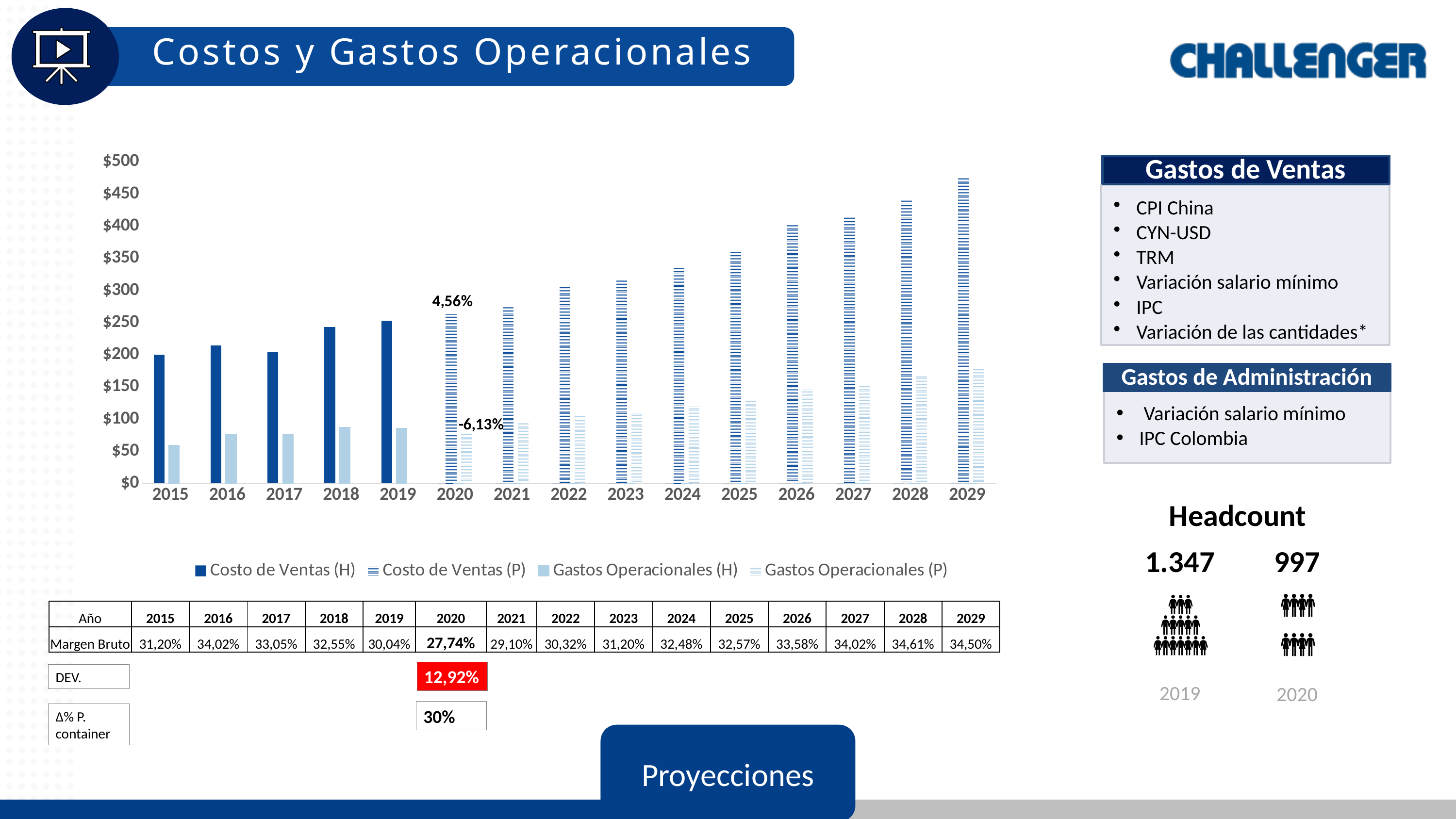
How many series does the chart legend list? 4 What percentage label is printed above the 2020 Costo de Ventas (P) bar? 4,56% Do the Costo de Ventas (P) values rise or fall from 2020 to 2029? rise Which is larger: Costo de Ventas (H) in 2018 or Costo de Ventas (H) in 2015? 2018 What kind of chart is shown on the slide? bar chart Is the value for Costo de Ventas (H) in 2019 greater or less than $200? greater How many years are shown on the x axis of the chart? 15 In which year is the Gastos Operacionales (H) bar the lowest? 2015 In which year is the Costo de Ventas (P) bar the tallest? 2029 Is the value for Costo de Ventas (P) in 2029 greater or less than $450? greater What percentage label is printed next to the 2020 Gastos Operacionales (P) bar? -6,13% Is the value for Gastos Operacionales (P) in 2029 greater or less than $200? less